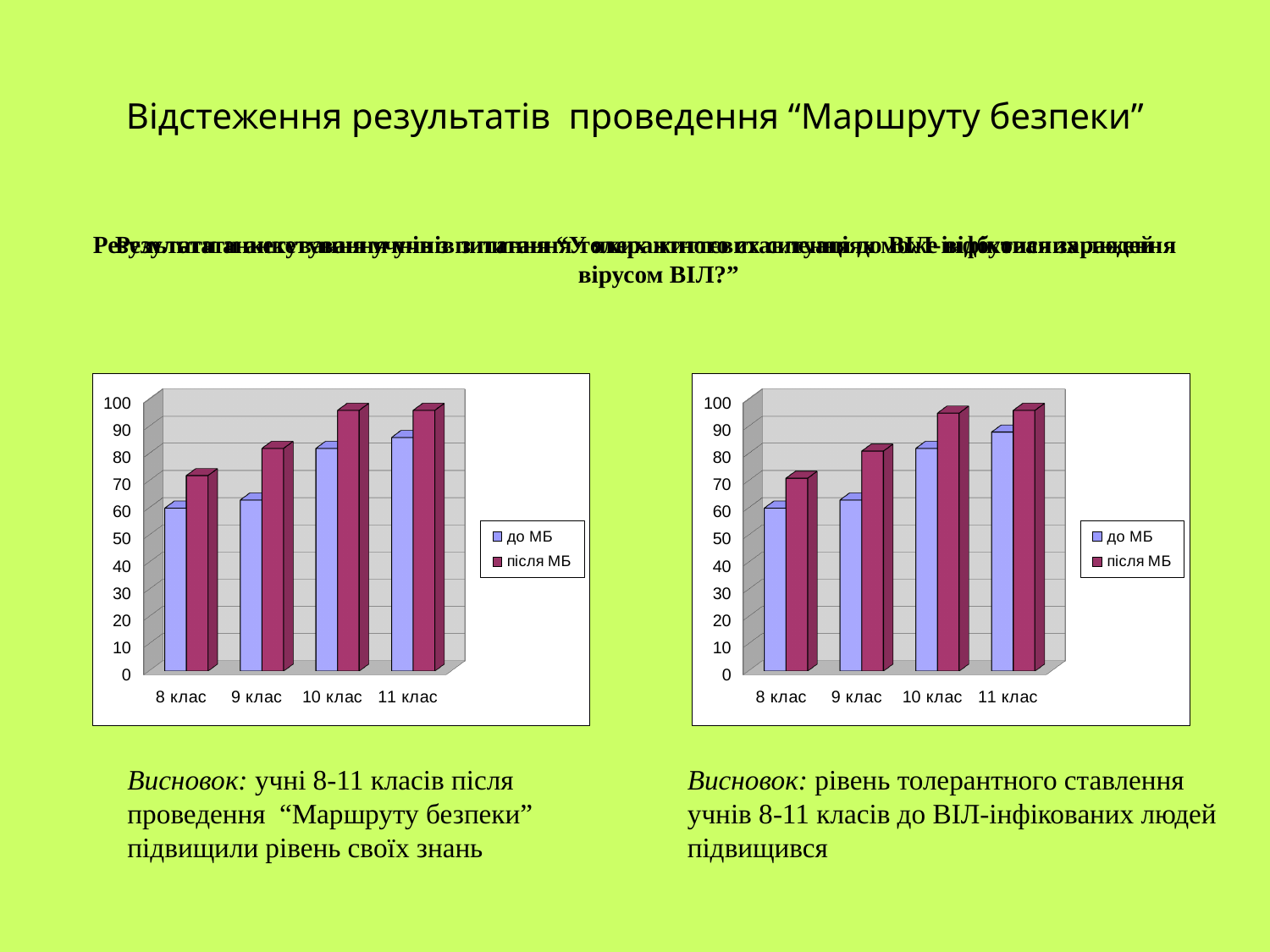
In the right chart, is the value for 11 клас in the після МБ series greater or less than 90? greater In the left chart, which series has the larger value for 11 клас, до МБ or після МБ? після МБ What are the two legend entries of the right chart? до МБ, після МБ How many categories are shown on the x axis of the right chart? 4 How many series does the legend of the left chart list? 2 In the right chart, is the value for 9 клас in the до МБ series greater or less than 70? less In the left chart, is the value for 8 клас in the до МБ series greater or less than 50? greater In the left chart, which category has the highest value in the до МБ series? 11 клас What kind of chart is the left chart on the slide? bar chart In the right chart, do the values of the після МБ series rise or fall from 8 клас to 11 клас? rise